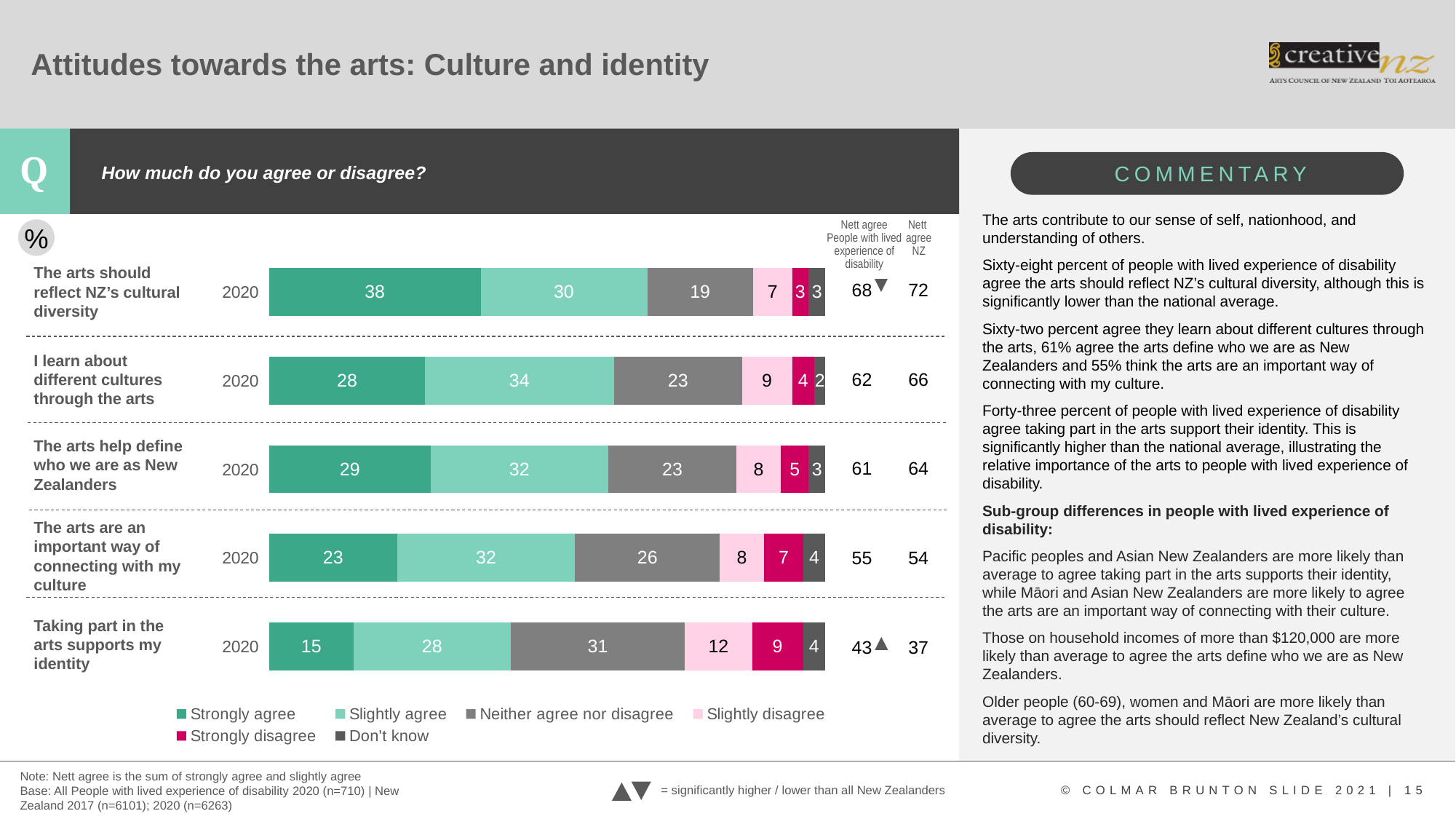
What is the 'Nett agree NZ' value for 'The arts help define who we are as New Zealanders'? 64 What is the 'Neither agree nor disagree' value for 'Taking part in the arts supports my identity'? 31 What is the total of the 'Strongly agree' and 'Slightly agree' segments for 'The arts are an important way of connecting with my culture'? 55 Which is larger: the 'Slightly disagree' value for 'Taking part in the arts supports my identity' or for 'The arts help define who we are as New Zealanders'? Taking part in the arts supports my identity How many series does the chart legend list? 6 What is the difference between the 'Slightly agree' values for 'I learn about different cultures through the arts' and 'Taking part in the arts supports my identity'? 6 What is the 'Strongly agree' value for 'The arts should reflect NZ's cultural diversity'? 38 Which statement has the lowest 'Strongly agree' value? Taking part in the arts supports my identity Which statement has the highest 'Strongly agree' value? The arts should reflect NZ's cultural diversity What is the 'Strongly disagree' value for 'The arts are an important way of connecting with my culture'? 7 What kind of chart is shown on the slide? Stacked bar chart How many statements (categories) are plotted in the chart? 5